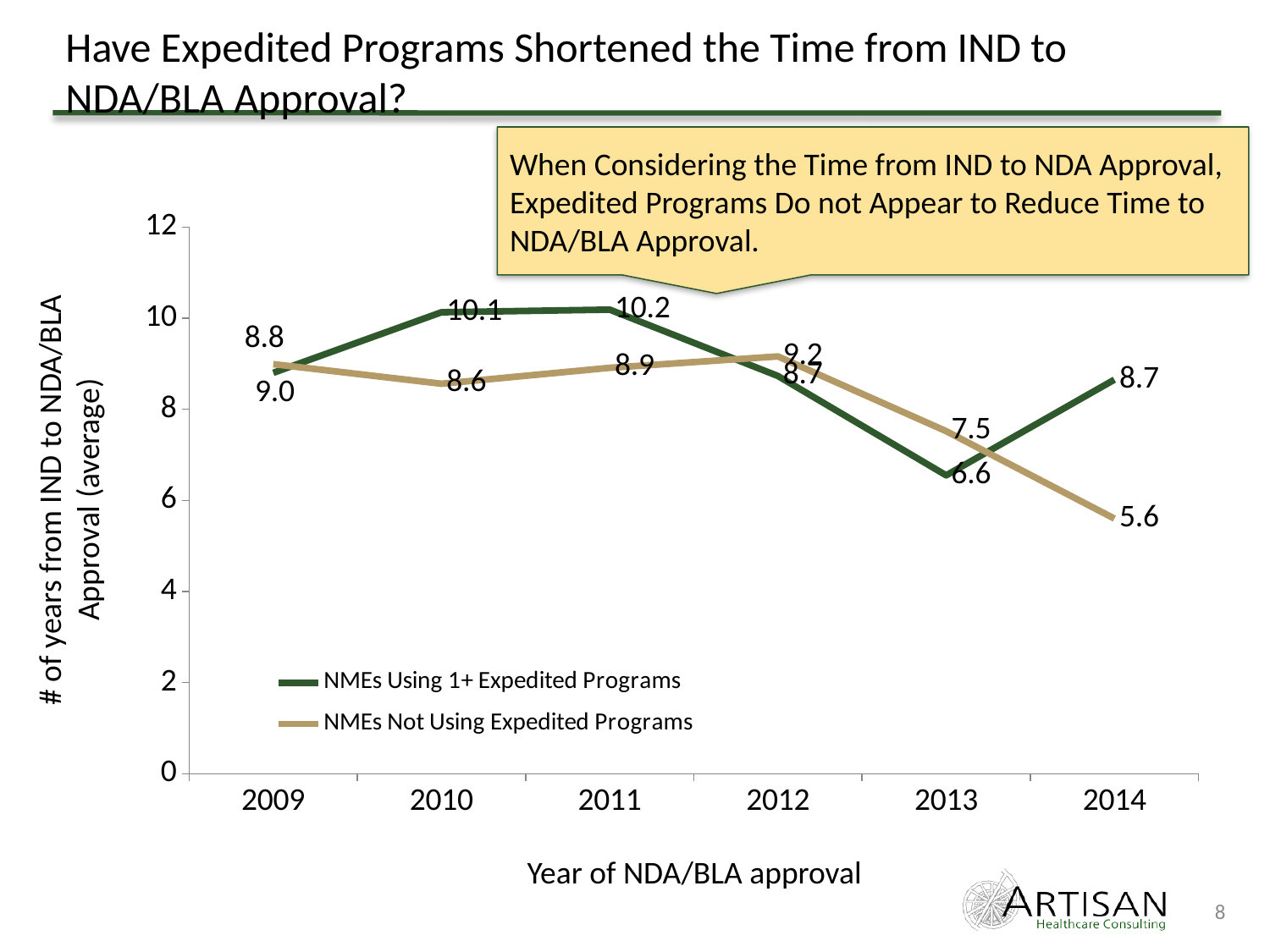
What is the value for NMEs Using 1+ Expedited Programs in 2013? 6.6 In which year is the value for NMEs Not Using Expedited Programs highest? 2012 What is the label of the x axis? Year of NDA/BLA approval How many series does the legend list? 2 What type of chart is shown on the slide? line chart What is the difference between the two series in 2014? 3.1 How many years are plotted along the x axis? 6 What is the value for NMEs Not Using Expedited Programs in 2014? 5.6 In 2010, which series has the larger value? NMEs Using 1+ Expedited Programs What is the value for NMEs Using 1+ Expedited Programs in 2011? 10.2 Does the value for NMEs Not Using Expedited Programs rise or fall from 2012 to 2014? fall In which year is the value for NMEs Using 1+ Expedited Programs lowest? 2013